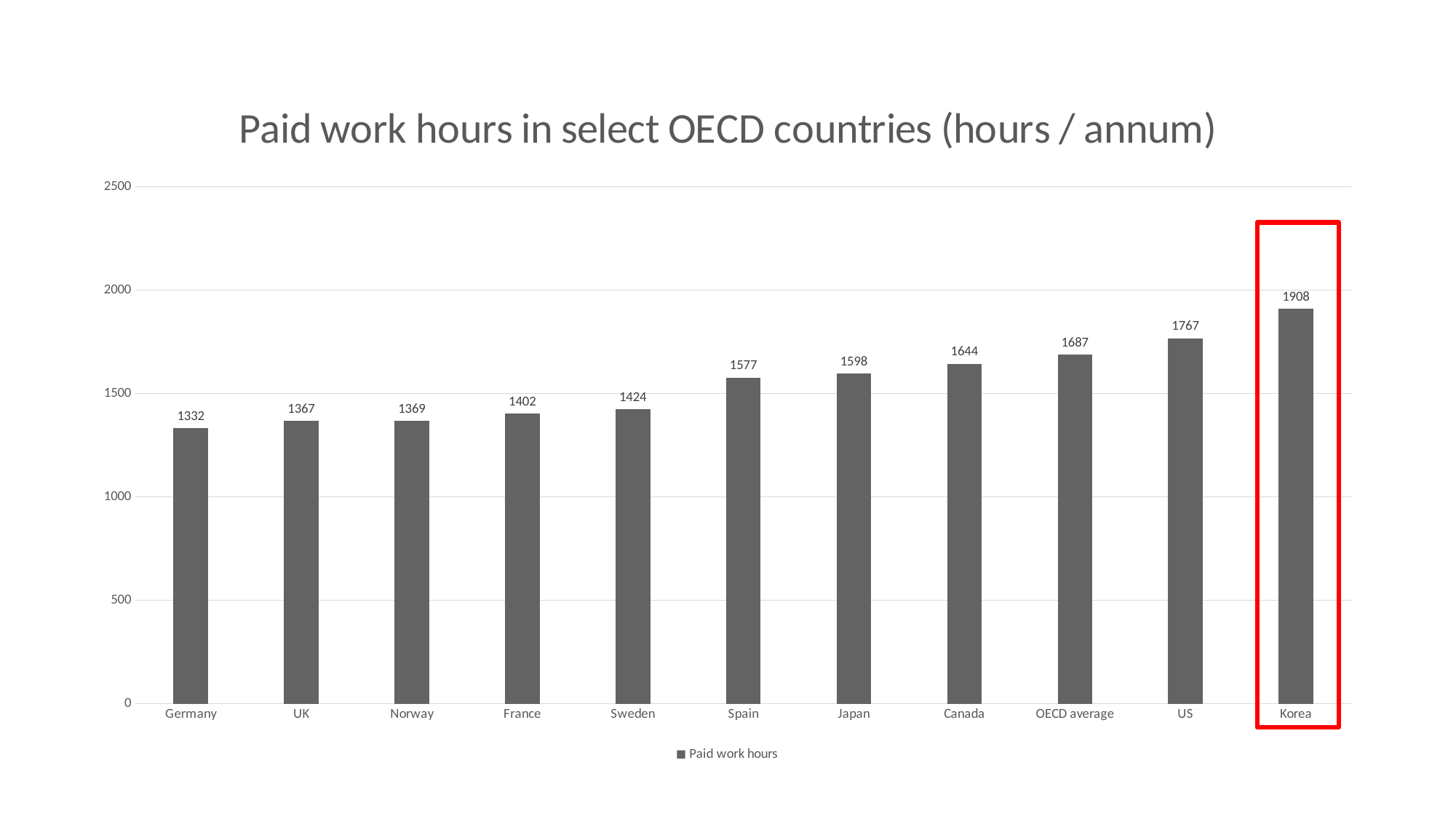
How many countries or categories are shown on the x axis? 11 Is the value for France greater or less than 1500? less What is the value for the OECD average? 1687 Which country has the highest paid work hours? Korea What is the value for Korea? 1908 What is the value for Germany? 1332 Which is larger, the value for Canada or the value for Sweden? Canada What is the difference between the values for Japan and Spain? 21 What is the difference between the values for Korea and the US? 141 Do the values rise or fall from left to right along the x axis? rise Which country has the lowest paid work hours? Germany What kind of chart is this? bar chart